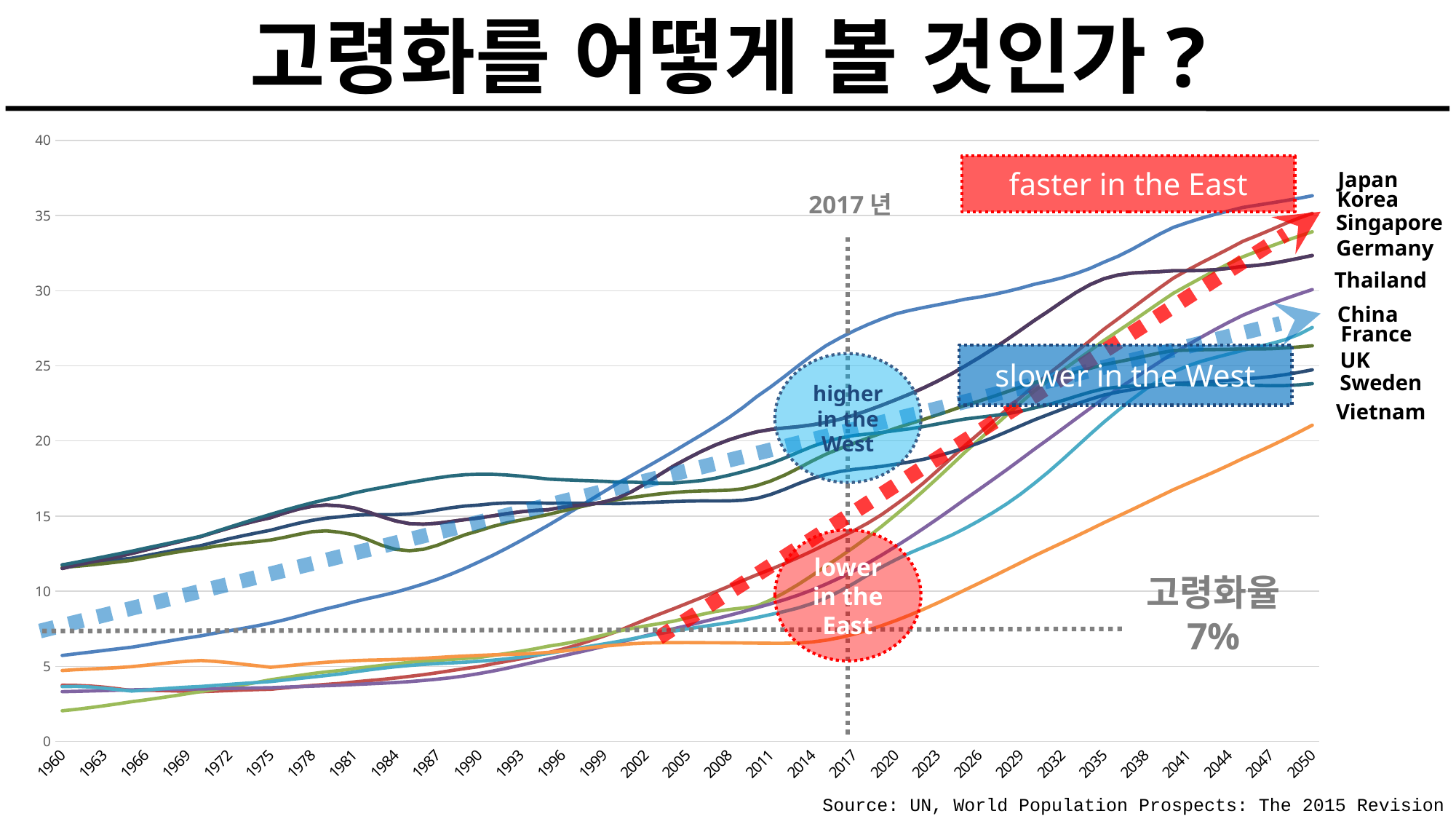
In 2050, which is larger, the value for Japan or the value for Vietnam? Japan What percentage does the horizontal dotted reference line on the chart represent? 7% Is the value for Japan in 1960 greater or less than 10? less Does the line for Japan rise or fall from 1960 to 2050? rise Which country has the highest value in 2050? Japan Is the value for Vietnam in 2050 greater or less than 25? less How many year labels are shown on the x axis? 31 What kind of chart is shown on the slide? line chart Is the value for Korea in 2050 greater or less than 30? greater How many countries are labelled on the right side of the chart? 10 Which country has the lowest value in 2050? Vietnam